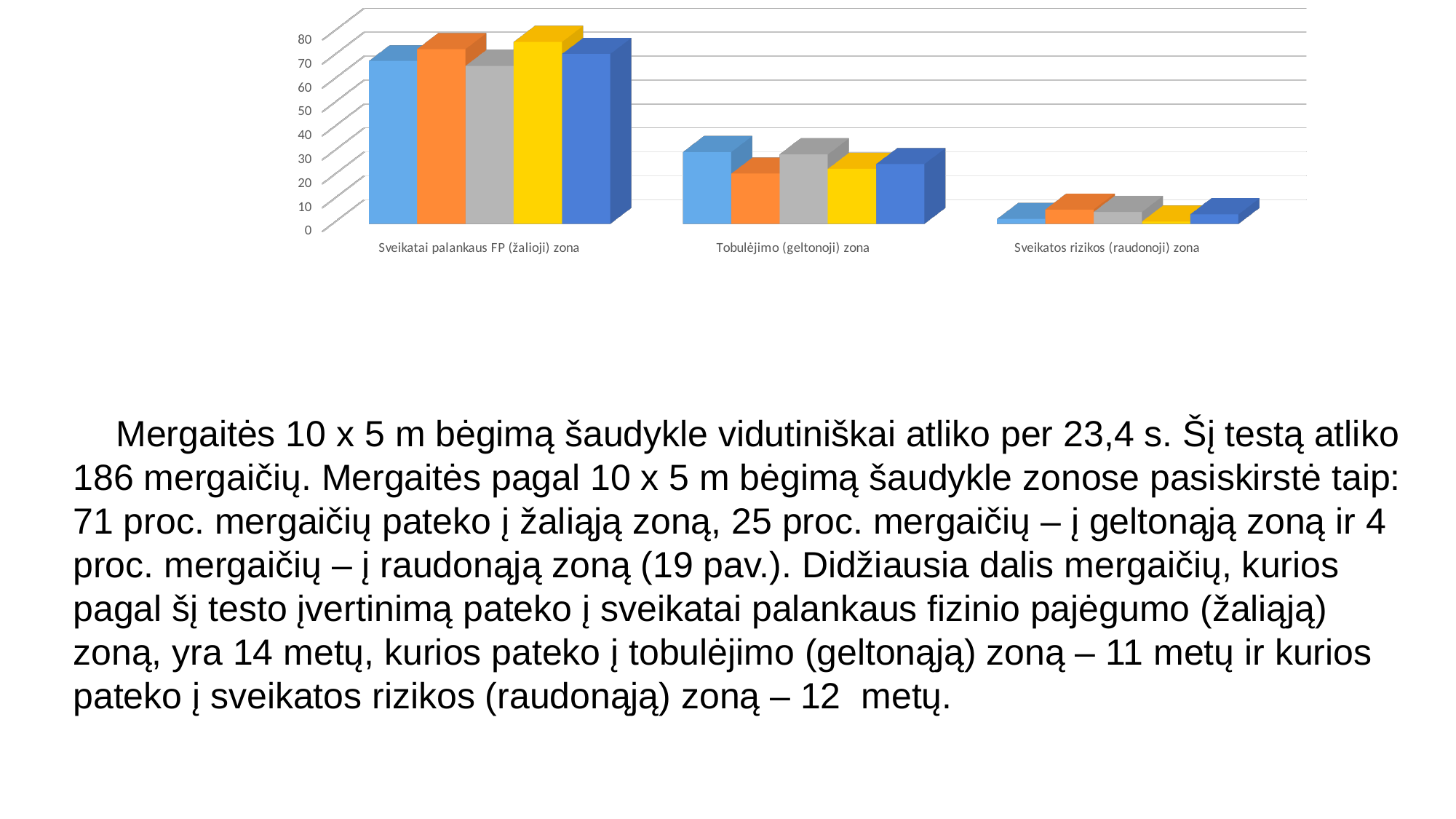
Do the bar heights rise or fall moving from left to right along the x axis? fall Which category has the shortest bars in the chart? Sveikatos rizikos (raudonoji) zona Are the bars for Tobulėjimo (geltonoji) zona greater or less than 40? less How many categories are shown on the x axis of the chart? 3 What kind of chart is shown on the slide? bar chart What colour is the first (leftmost) bar in each category group? light blue Are the bars for Sveikatos rizikos (raudonoji) zona greater or less than 10? less Which category has larger bars, Tobulėjimo (geltonoji) zona or Sveikatos rizikos (raudonoji) zona? Tobulėjimo (geltonoji) zona Which category has the tallest bars in the chart? Sveikatai palankaus FP (žalioji) zona Are the bars for Sveikatai palankaus FP (žalioji) zona greater or less than 60? greater What is the highest value shown on the vertical axis of the chart? 80 How many bars are grouped within each category of the chart? 5